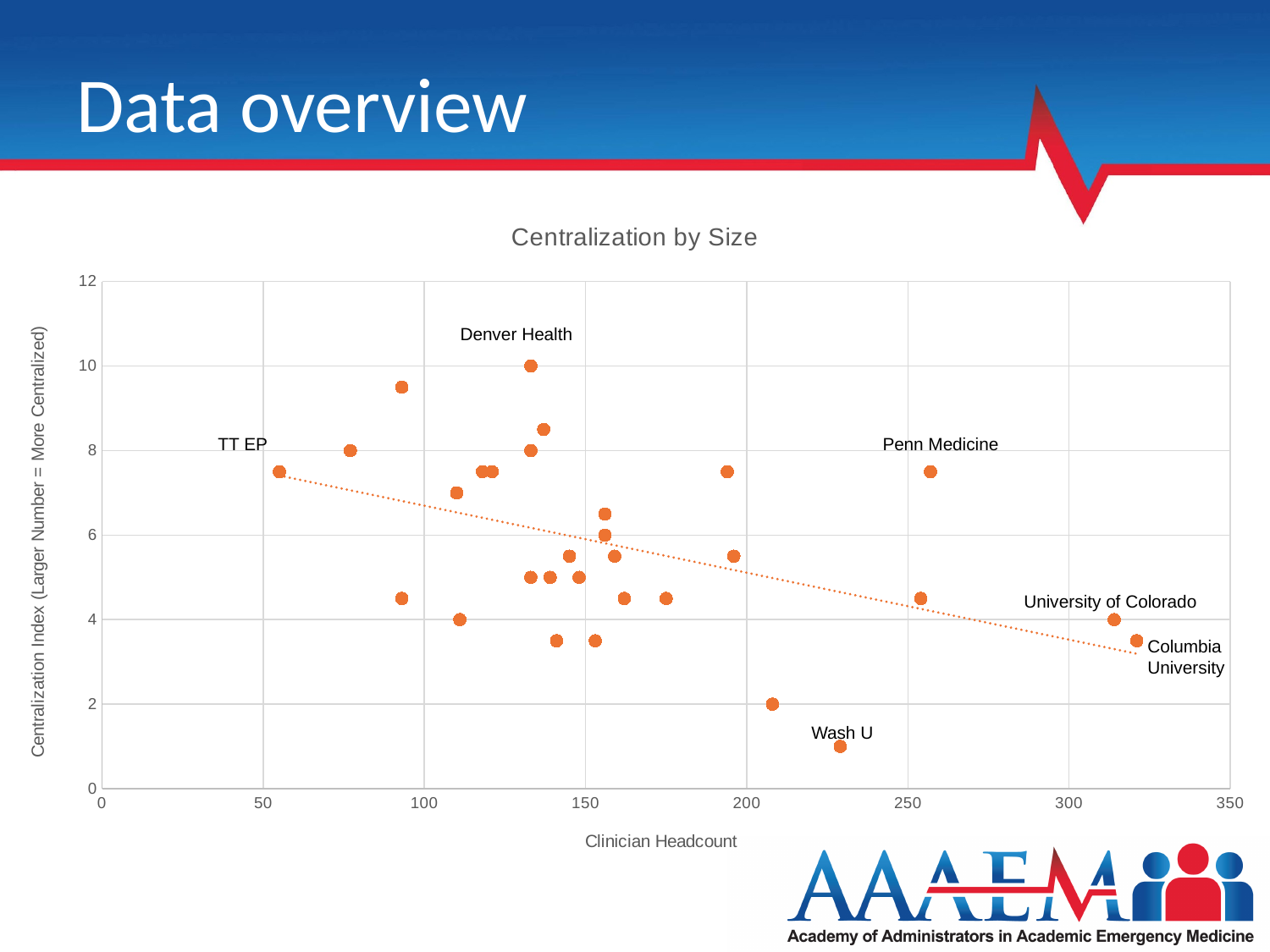
Is the centralization index for Wash U greater or less than 2? less What kind of chart is shown on the slide? scatter chart Among the labeled institutions, which has the highest centralization index? Denver Health Among the labeled institutions, which has the lowest centralization index? Wash U Is the clinician headcount for TT EP greater or less than 100? less What is the label of the x axis? Clinician Headcount Does the dotted trend line rise or fall as clinician headcount increases? fall Which has the higher centralization index, Denver Health or Wash U? Denver Health Is the centralization index for Denver Health greater or less than 8? greater What is the title of the chart? Centralization by Size Which has the larger clinician headcount, Columbia University or TT EP? Columbia University